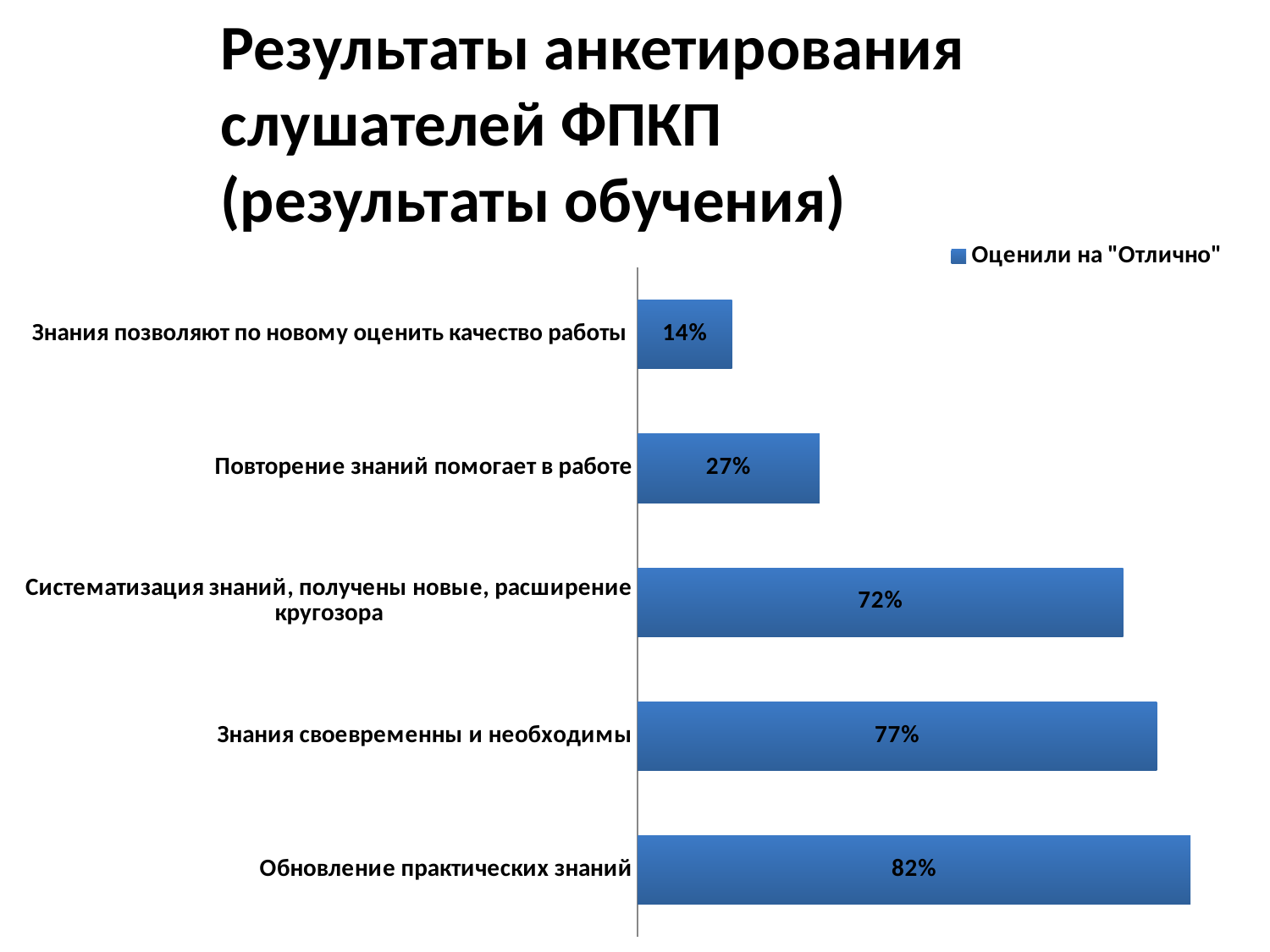
Which is larger: the value for "Систематизация знаний, получены новые, расширение кругозора" or for "Повторение знаний помогает в работе"? Систематизация знаний, получены новые, расширение кругозора What is the difference between the values for "Систематизация знаний, получены новые, расширение кругозора" and "Повторение знаний помогает в работе"? 45% What series name does the legend show? Оценили на "Отлично" What value is shown for "Знания своевременны и необходимы"? 77% What value is shown for "Обновление практических знаний"? 82% How many categories are shown in the chart? 5 Which category has the highest value? Обновление практических знаний What is the difference between the values for "Обновление практических знаний" and "Знания своевременны и необходимы"? 5% What value is shown for "Знания позволяют по новому оценить качество работы"? 14% Which category has the lowest value? Знания позволяют по новому оценить качество работы What kind of chart is shown on the slide? Bar chart What value is shown for "Повторение знаний помогает в работе"? 27%